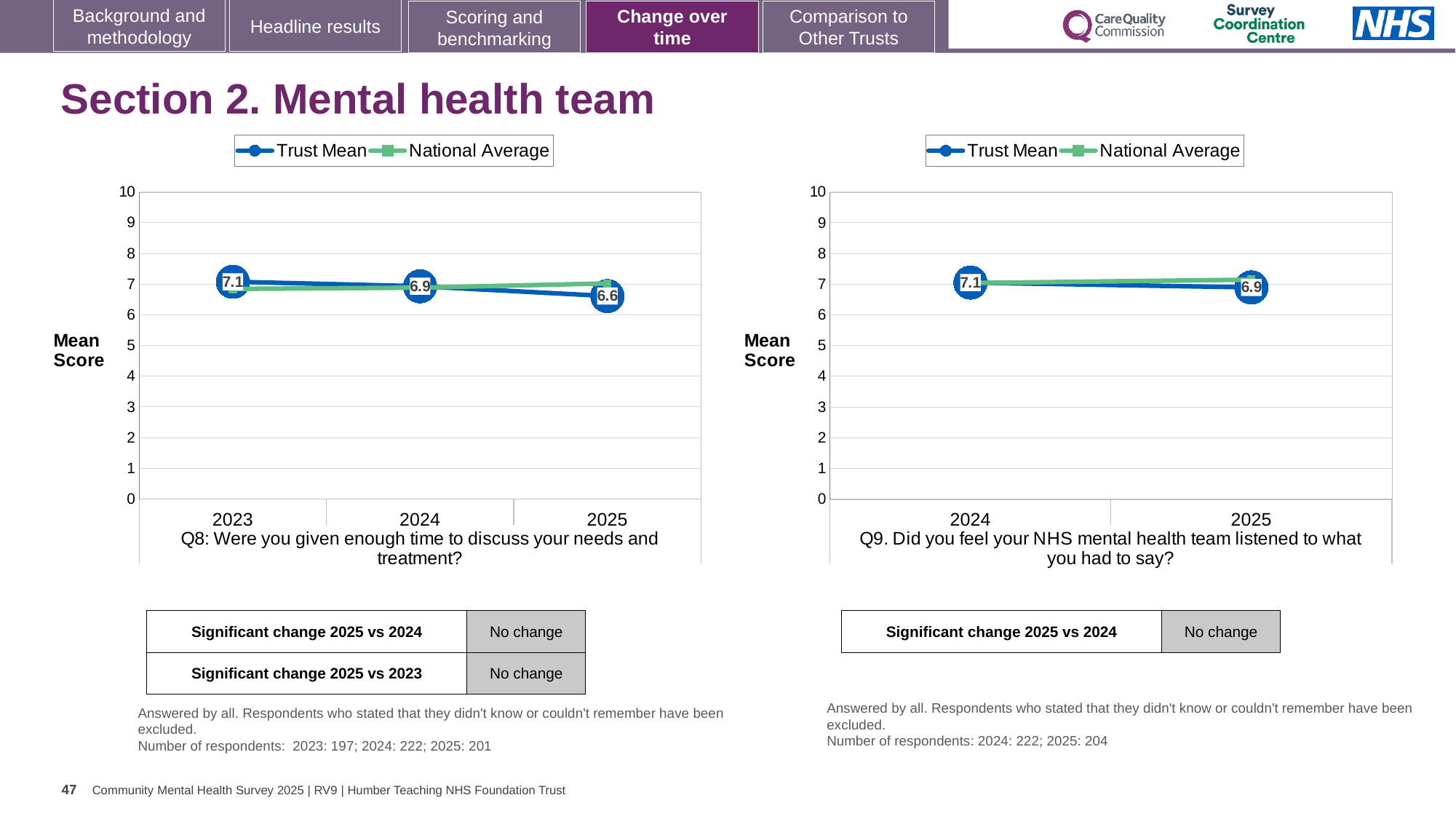
What kind of chart is the Q8 chart (left)? line chart On the Q8 chart (left), in which year is the Trust Mean highest? 2023 On the Q8 chart (left), what is the Trust Mean for 2024? 6.9 On the Q8 chart (left), in which year is the Trust Mean lowest? 2025 How many years are plotted on the Q8 chart (left)? 3 On the Q9 chart (right), does the Trust Mean rise or fall from 2024 to 2025? fall On the Q8 chart (left), what is the difference between the Trust Mean in 2023 and in 2025? 0.5 On the Q9 chart (right), what is the Trust Mean for 2025? 6.9 On the Q9 chart (right), what is the Trust Mean for 2024? 7.1 How many series does the legend of the Q9 chart (right) list? 2 On the Q8 chart (left), what is the Trust Mean for 2025? 6.6 On the Q8 chart (left), what is the Trust Mean for 2023? 7.1